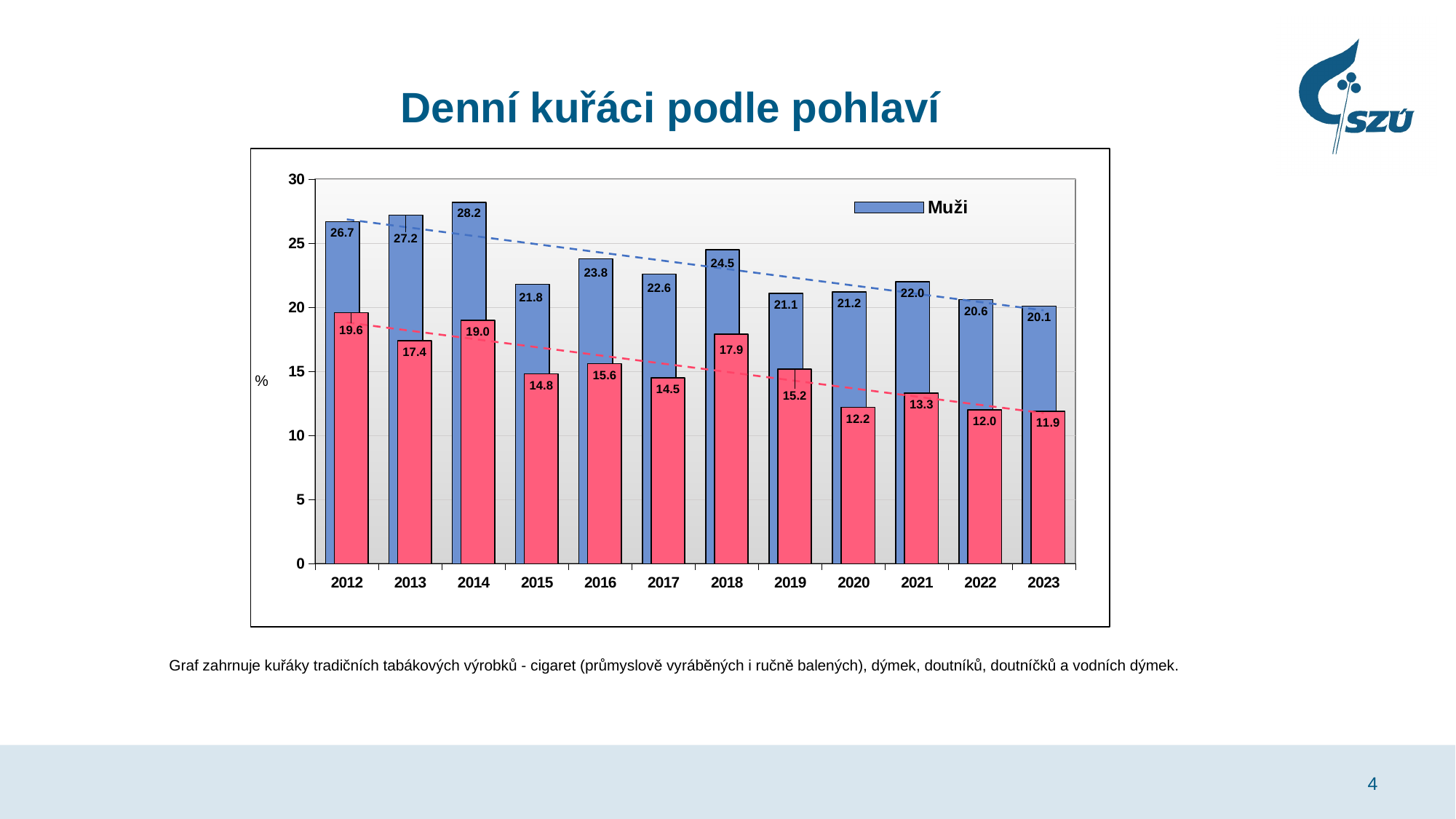
What is the value for Muži in 2019? 21.1 What is the difference between the Muži bar and the pink bar in 2023? 8.2 How many years are shown on the x axis? 12 What is the value of the pink bar for 2020? 12.2 In which year is the pink bar lowest? 2023 Which year has the larger Muži value, 2017 or 2018? 2018 In which year is the Muži value highest? 2014 Is the Muži value for 2016 greater or less than 25? less Do the Muži values generally rise or fall from 2012 to 2023? fall What kind of chart is shown on the slide? bar chart What is the value for Muži in 2014? 28.2 By how much did the Muži value fall from 2012 to 2023? 6.6